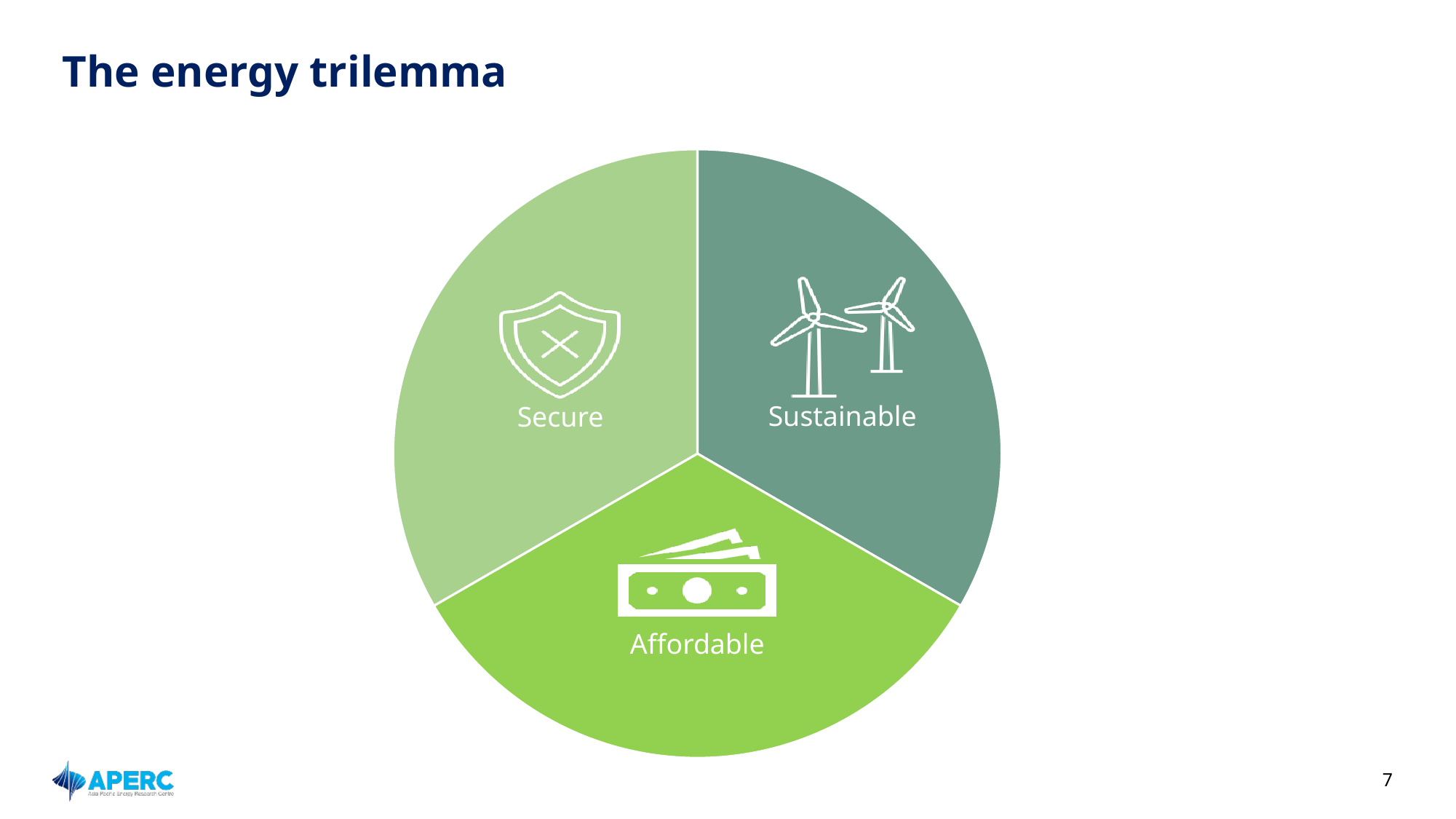
Which slice of the pie chart is at the bottom? Affordable What is the title of the slide containing the pie chart? The energy trilemma Which slice of the pie chart is on the right side? Sustainable Which slice of the pie chart is labelled with a shield icon? Secure How many slices does the pie chart have? 3 Which slice of the pie chart is labelled with a banknote icon? Affordable Which slice of the pie chart is labelled with wind turbine icons? Sustainable Which slice of the pie chart is on the left side? Secure What kind of chart is shown on the slide? pie chart